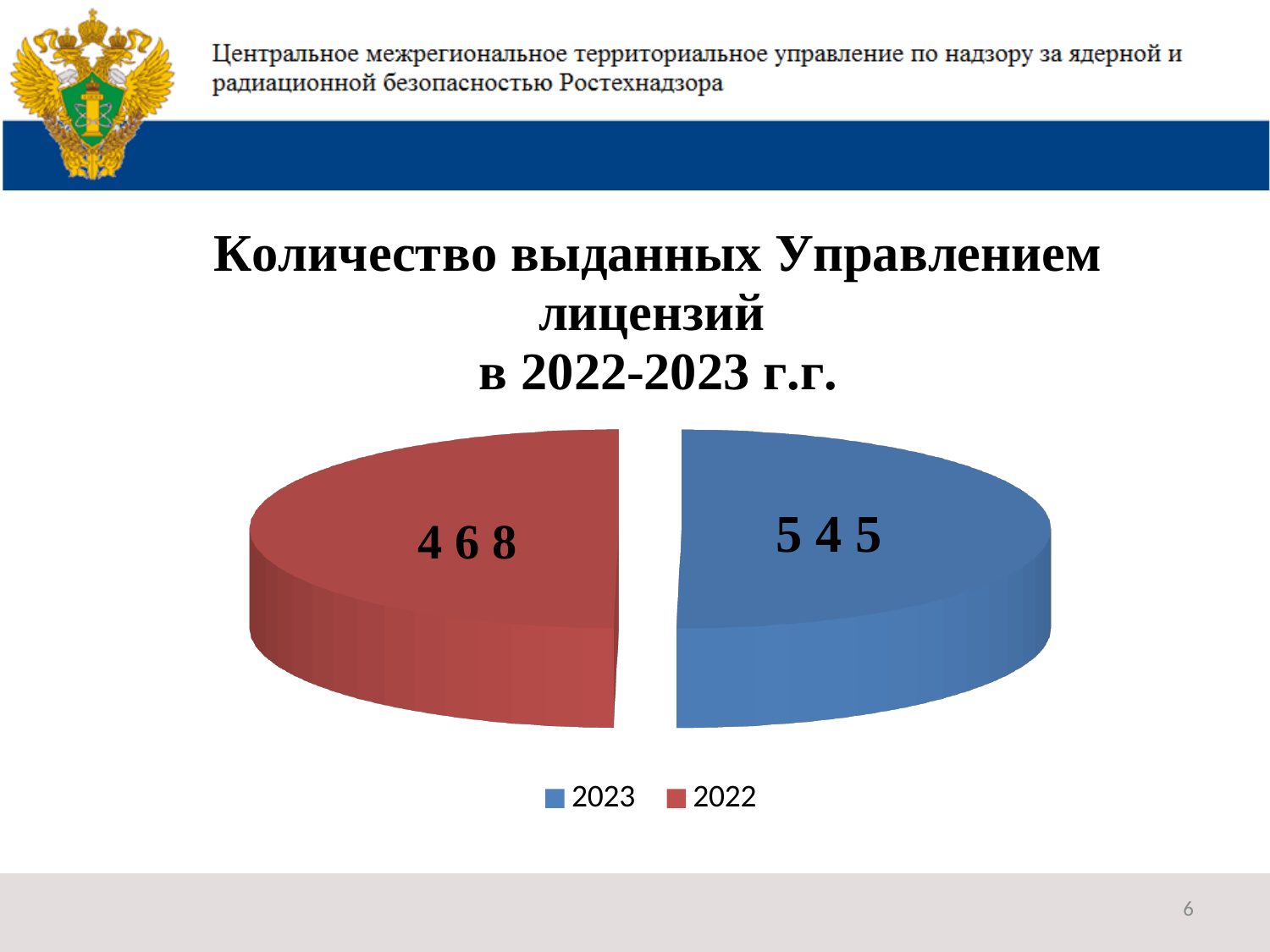
What is the total number of licences across both years shown in the pie chart? 1013 Which colour represents 2022 in the pie chart? red What type of chart is shown on the slide? pie chart How many entries does the legend list? 2 How many licences were issued in 2022 according to the chart? 468 Is the value for 2023 larger or smaller than the value for 2022? larger Which year has the larger slice in the pie chart? 2023 Which year has the smaller slice in the pie chart? 2022 How many licences were issued in 2023 according to the chart? 545 What is the difference between the number of licences issued in 2023 and in 2022? 77 How many slices does the pie chart have? 2 What is the title of the chart? Количество выданных Управлением лицензий в 2022-2023 г.г.